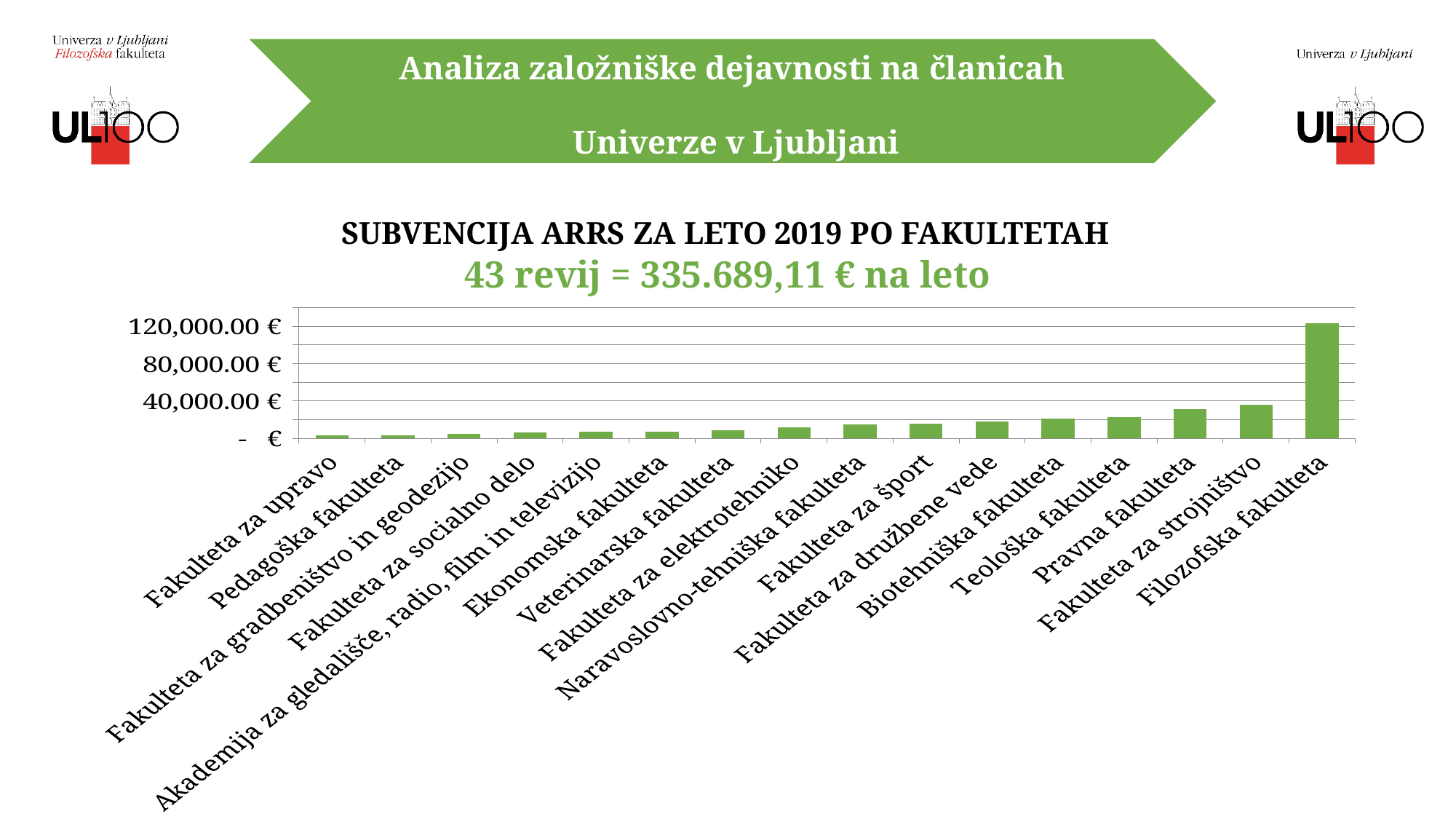
According to the chart subtitle, what is the total yearly subsidy for the 43 journals? 335.689,11 € How many faculties are shown on the x axis of the chart? 16 Which has a larger value, Filozofska fakulteta or Fakulteta za strojništvo? Filozofska fakulteta Is the value for Fakulteta za strojništvo greater or less than 40,000.00 €? less What is the title of the chart? SUBVENCIJA ARRS ZA LETO 2019 PO FAKULTETAH Is the value for Filozofska fakulteta greater or less than 80,000.00 €? greater What kind of chart is shown on the slide? bar chart Is the value for Pravna fakulteta greater or less than 40,000.00 €? less Do the bar values rise or fall from left to right along the x axis? rise Which faculty has the lowest ARRS subsidy in the chart? Fakulteta za upravo and Pedagoška fakulteta (tied) Which has a larger value, Pravna fakulteta or Teološka fakulteta? Pravna fakulteta Which faculty has the highest ARRS subsidy in the chart? Filozofska fakulteta